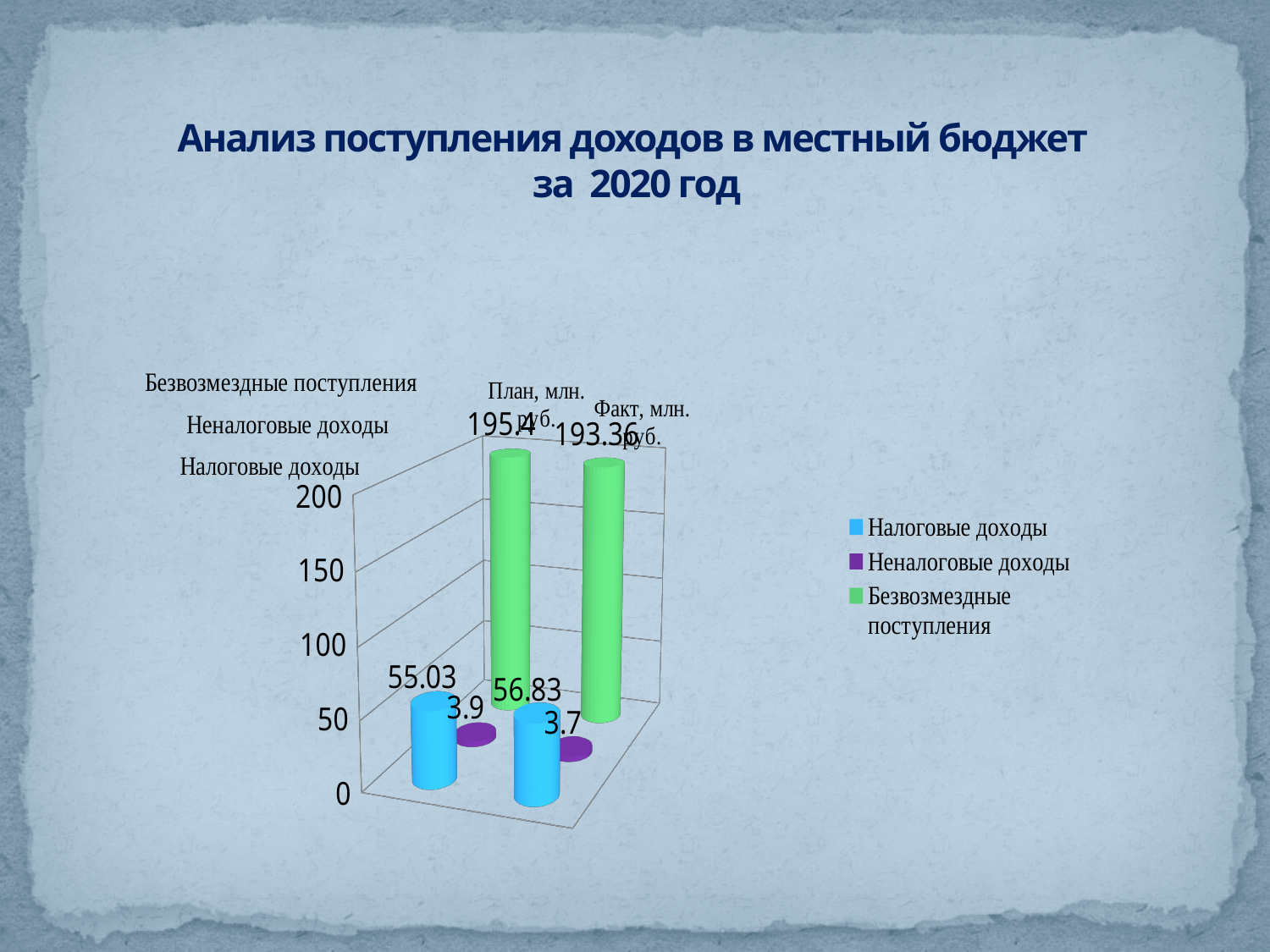
What is the value of Безвозмездные поступления for План, млн. руб.? 195.4 Which series has the lowest value for План, млн. руб.? Неналоговые доходы What is the value of Неналоговые доходы for План, млн. руб.? 3.9 What kind of chart is shown on the slide? Bar chart Which series has the highest value for Факт, млн. руб.? Безвозмездные поступления What is the value of Налоговые доходы for Факт, млн. руб.? 56.83 How many series does the legend list? 3 What is the value of Налоговые доходы for План, млн. руб.? 55.03 What is the value of Неналоговые доходы for Факт, млн. руб.? 3.7 What is the value of Безвозмездные поступления for Факт, млн. руб.? 193.36 What is the difference between the План and Факт values for Налоговые доходы? 1.8 Which is larger: Безвозмездные поступления for План or for Факт? План